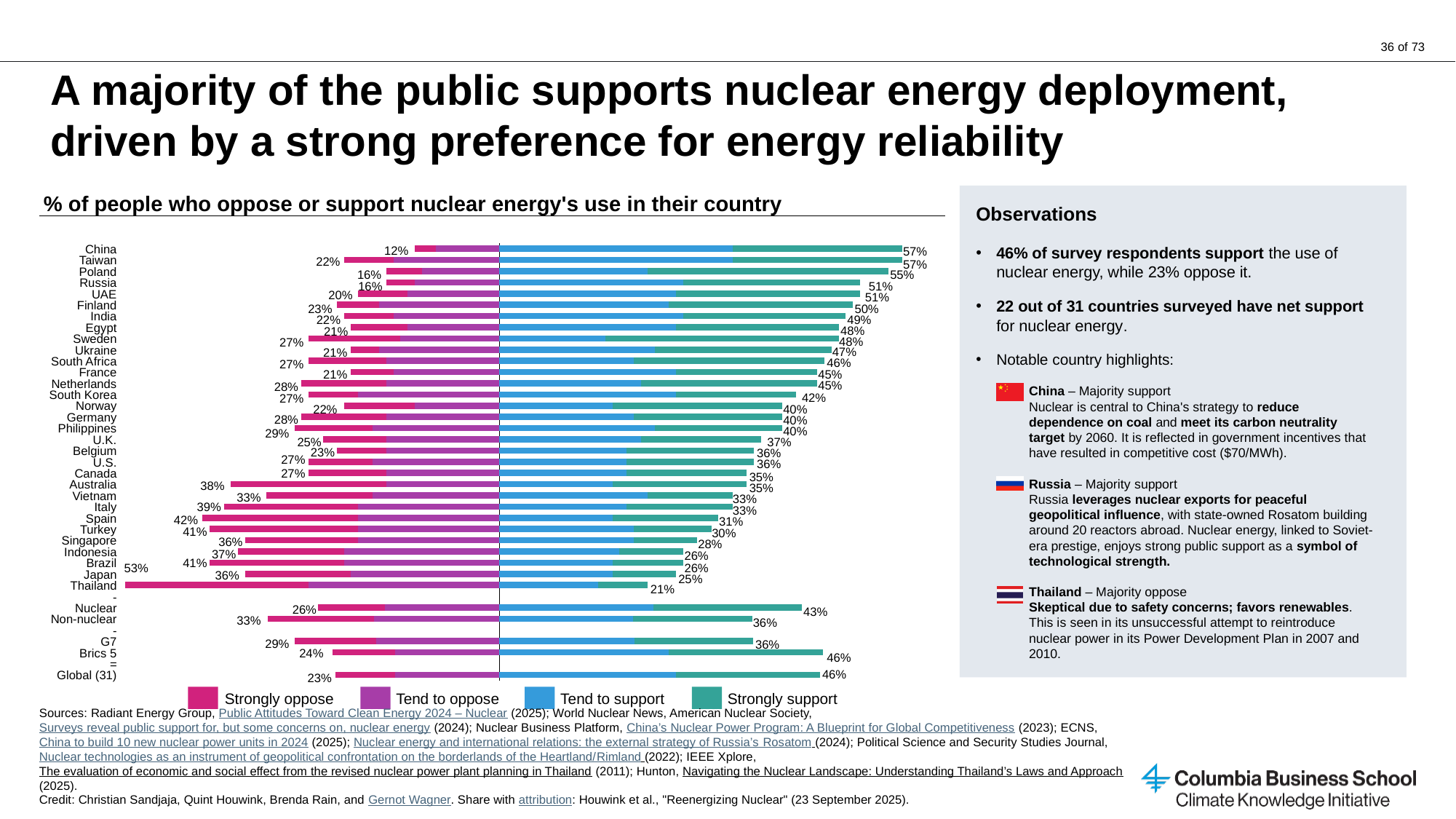
What kind of chart is shown on the slide? Bar chart What is the difference between the oppose percentage for Spain and the oppose percentage for Poland? 26% Which country has the lowest share of people opposing nuclear energy? China What percentage of people in China support nuclear energy's use in their country? 57% Which legend entry is shown in pink? Strongly oppose What is the title of the chart? % of people who oppose or support nuclear energy's use in their country What percentage of people in Thailand oppose nuclear energy's use in their country? 53% Which has a higher support percentage, Nuclear countries or Non-nuclear countries? Nuclear Which country has the lowest share of people supporting nuclear energy? Thailand What is the Global (31) support percentage shown at the bottom of the chart? 46% How many series does the legend list? 4 What is the difference between the support percentage for Russia and the support percentage for Japan? 26%